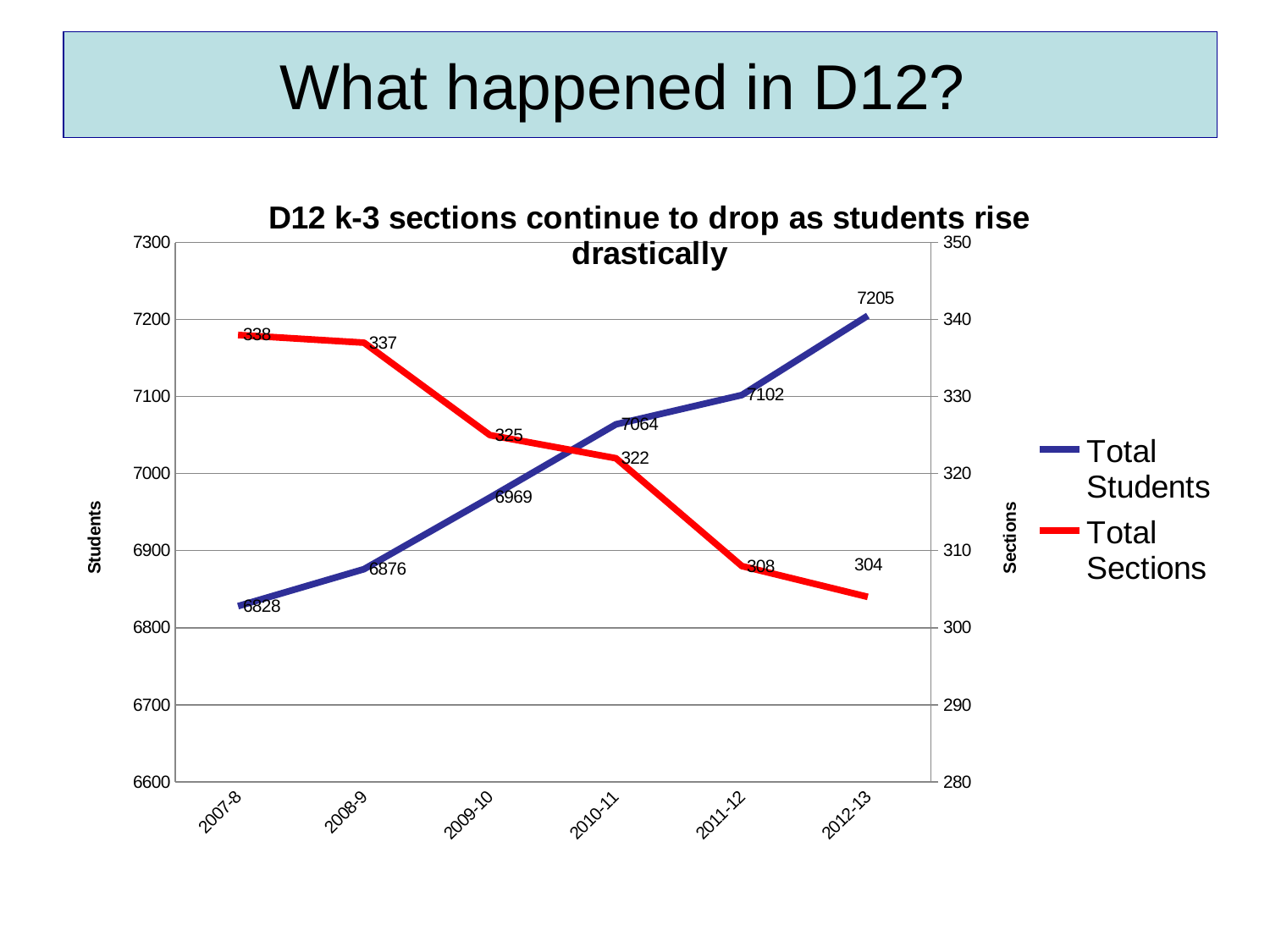
What is the value of Total Sections in 2009-10? 325 What is the value of Total Students in 2012-13? 7205 In which year is Total Students highest? 2012-13 How many series does the legend list? 2 Which is larger, Total Sections in 2010-11 or in 2011-12? 2010-11 What is the difference in Total Students between 2012-13 and 2007-8? 377 What is the value of Total Sections in 2012-13? 304 What is the value of Total Students in 2007-8? 6828 How many years are shown on the x axis? 6 In which year is Total Sections lowest? 2012-13 What kind of chart is shown on the slide? Line chart What is the difference in Total Sections between 2007-8 and 2012-13? 34